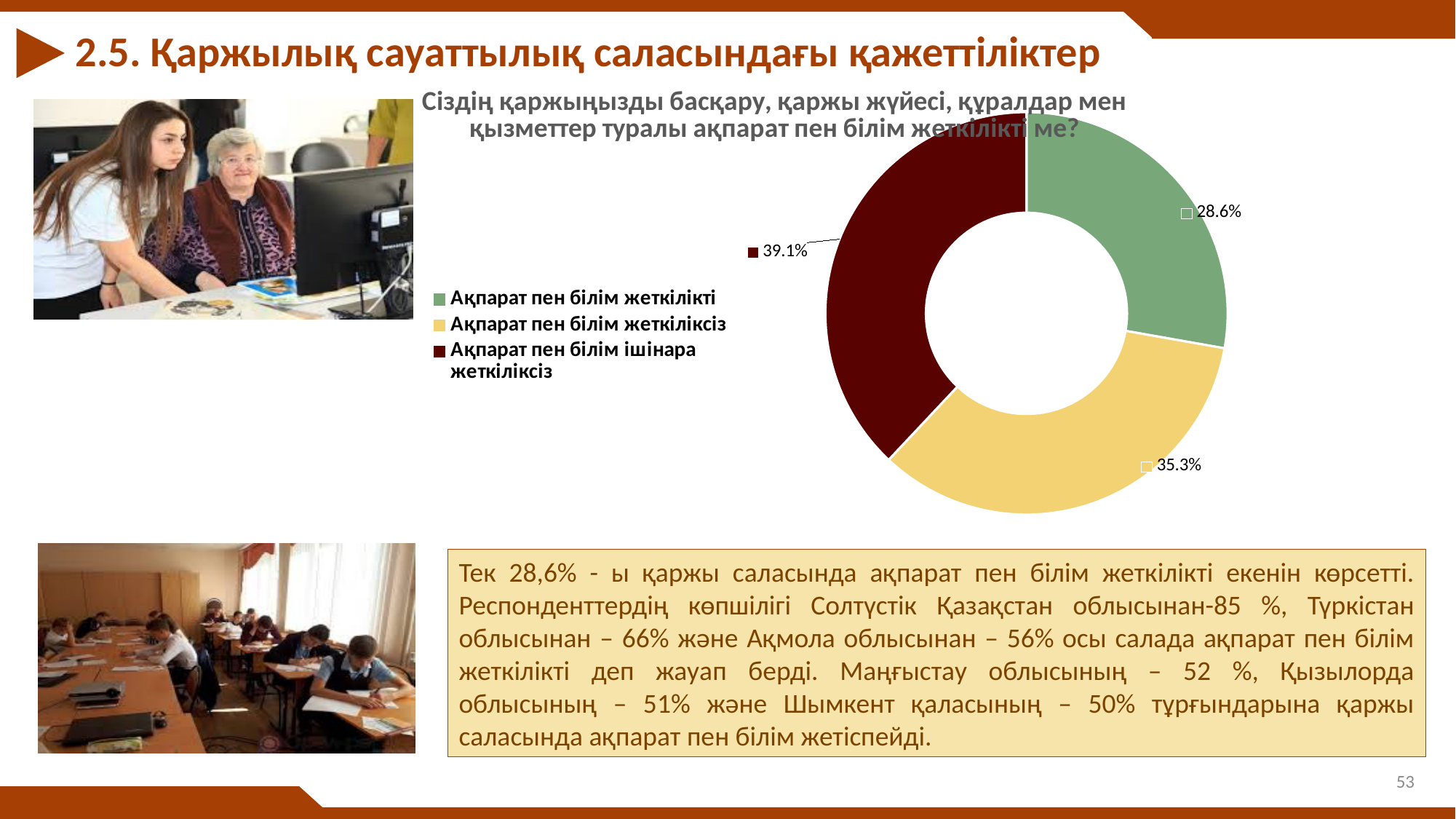
What share of respondents answered "Ақпарат пен білім ішінара жеткіліксіз"? 39.1% What is the difference in percentage points between "Ақпарат пен білім жеткіліксіз" and "Ақпарат пен білім жеткілікті"? 6.7 percentage points What share of respondents answered "Ақпарат пен білім жеткіліксіз"? 35.3% What is the difference in percentage points between "Ақпарат пен білім ішінара жеткіліксіз" and "Ақпарат пен білім жеткілікті"? 10.5 percentage points What kind of chart is shown on the slide? Doughnut (pie) chart Which response category has the largest share in the chart? Ақпарат пен білім ішінара жеткіліксіз Which is larger: the share for "Ақпарат пен білім жеткіліксіз" or the share for "Ақпарат пен білім жеткілікті"? Ақпарат пен білім жеткіліксіз How many categories does the chart show? 3 Which colour represents "Ақпарат пен білім ішінара жеткіліксіз" in the chart? Dark red Which response category has the smallest share in the chart? Ақпарат пен білім жеткілікті What is the title of the chart? Сіздің қаржыңызды басқару, қаржы жүйесі, құралдар мен қызметтер туралы ақпарат пен білім жеткілікті ме? What share of respondents answered "Ақпарат пен білім жеткілікті"? 28.6%